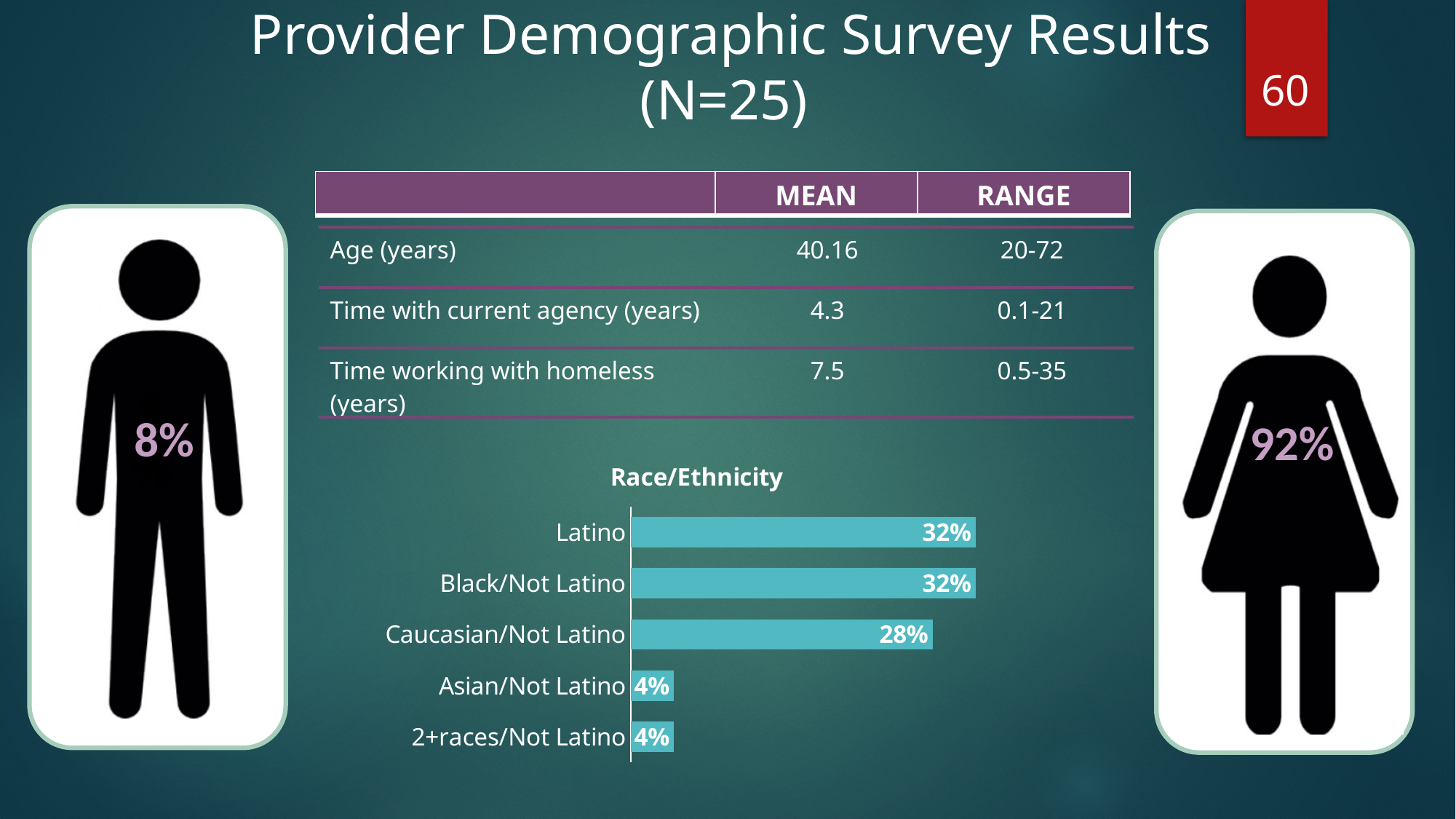
What is the difference between the Latino and Caucasian/Not Latino values in the Race/Ethnicity chart? 4% What is the value for Caucasian/Not Latino in the Race/Ethnicity chart? 28% What is the title of the chart on the slide? Race/Ethnicity How many categories are shown in the Race/Ethnicity chart? 5 What is the value for Asian/Not Latino in the Race/Ethnicity chart? 4% What is the value for Latino in the Race/Ethnicity chart? 32% What kind of chart is the Race/Ethnicity chart? Bar chart What is the difference between the Caucasian/Not Latino and Asian/Not Latino values in the Race/Ethnicity chart? 24% Which categories share the highest value in the Race/Ethnicity chart? Latino and Black/Not Latino What is the value for Black/Not Latino in the Race/Ethnicity chart? 32% Which categories share the lowest value in the Race/Ethnicity chart? Asian/Not Latino and 2+races/Not Latino Which is larger in the Race/Ethnicity chart, Caucasian/Not Latino or 2+races/Not Latino? Caucasian/Not Latino